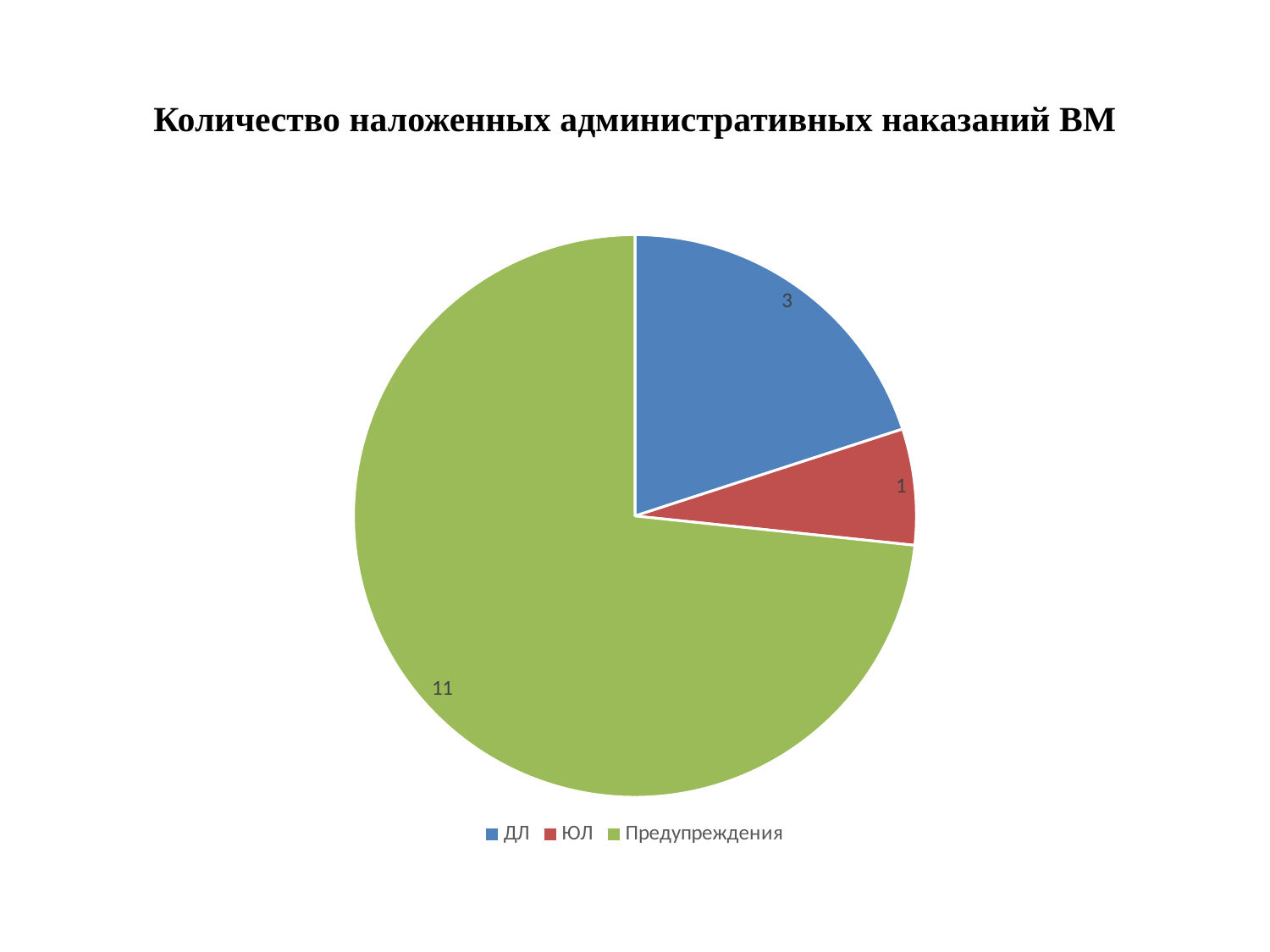
Which category has the smallest slice? ЮЛ Which is larger, the value for ДЛ or the value for ЮЛ? ДЛ What is the value for ЮЛ? 1 What is the value for ДЛ? 3 What is the title of the chart? Количество наложенных административных наказаний ВМ What colour is the slice for Предупреждения? green What is the total of all slices in the pie chart? 15 How many categories does the pie chart show? 3 What kind of chart is shown on the slide? pie chart What is the difference between the values for Предупреждения and ДЛ? 8 Which category has the largest slice? Предупреждения What is the value for Предупреждения? 11